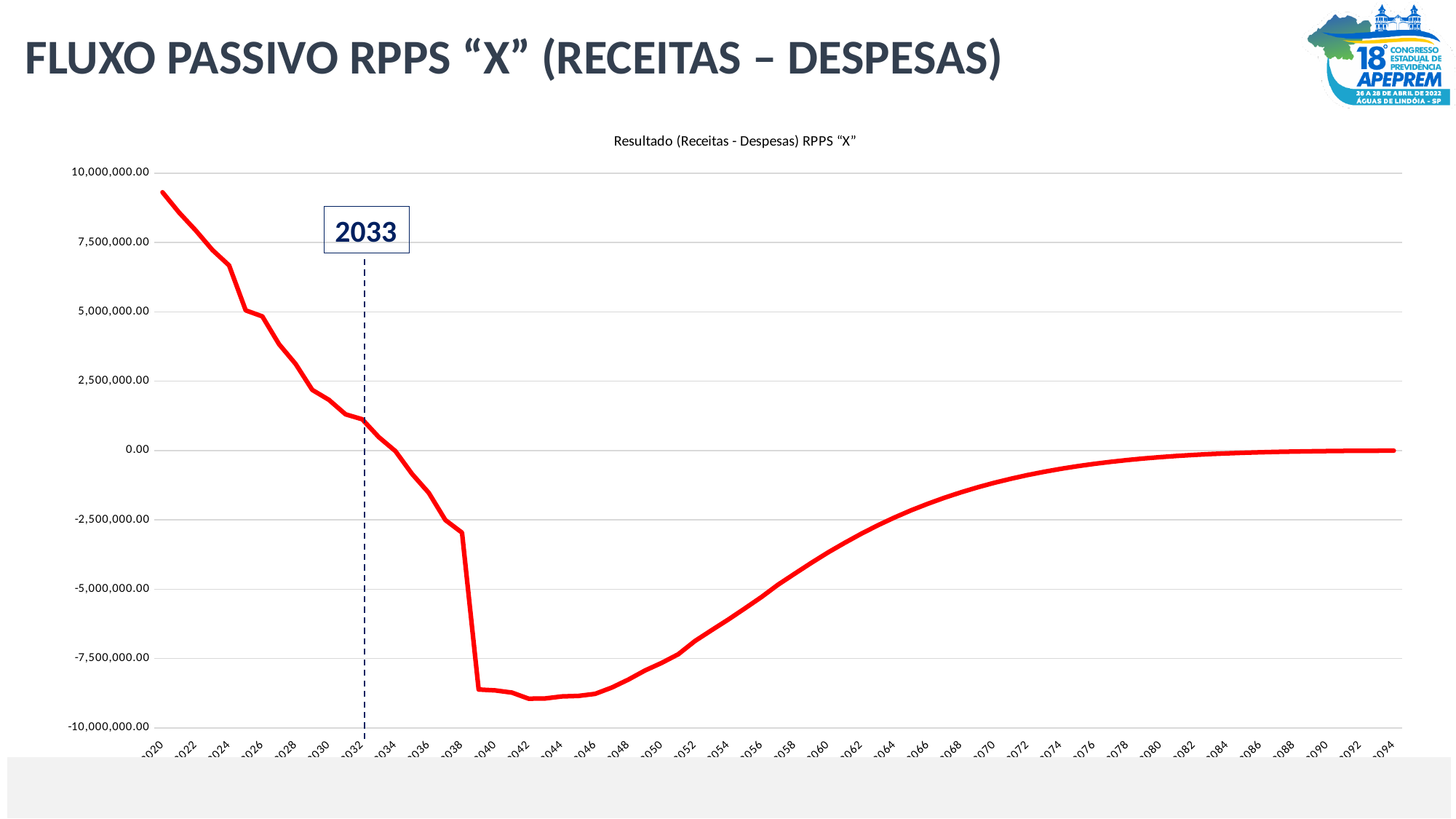
What is the title of the chart? Resultado (Receitas - Despesas) RPPS "X" What kind of chart is shown on the slide? Line chart Is the value for 2070 greater or less than -2,500,000.00? greater Is the value for 2024 greater or less than 5,000,000.00? greater Does the line rise or fall between 2020 and 2040? Falls Is the value for 2060 greater or less than -2,500,000.00? less Which year has the highest value on the chart? 2020 Which year is marked by the dashed vertical line on the chart? 2033